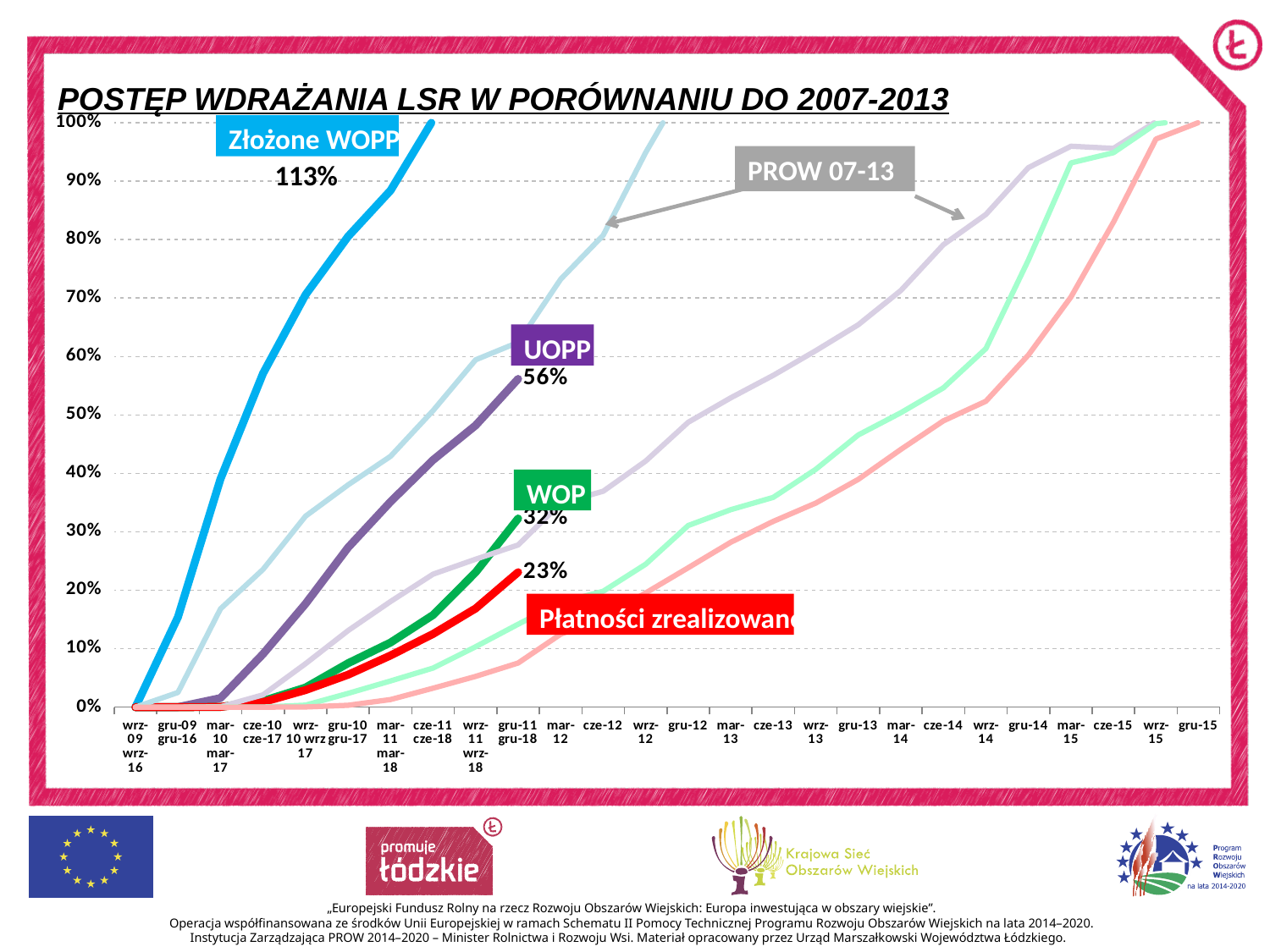
Do the plotted lines generally rise or fall along the x axis? rise What is the difference in percentage points between the labelled values for WOP and Płatności zrealizowane? 9 percentage points Which of the labelled 2014-2020 series (Złożone WOPP, UOPP, WOP, Płatności zrealizowane) has the highest labelled value? Złożone WOPP What is the title of the chart? POSTĘP WDRAŻANIA LSR W PORÓWNANIU DO 2007-2013 Which is larger, the labelled value for UOPP or for WOP? UOPP What is the difference in percentage points between the labelled values for UOPP and WOP? 24 percentage points What value is labelled for UOPP? 56% What value is labelled for Złożone WOPP? 113% What value is labelled for WOP? 32% What type of chart is shown on the slide? line chart What value is labelled for Płatności zrealizowane? 23% Which of the labelled 2014-2020 series (Złożone WOPP, UOPP, WOP, Płatności zrealizowane) has the lowest labelled value? Płatności zrealizowane